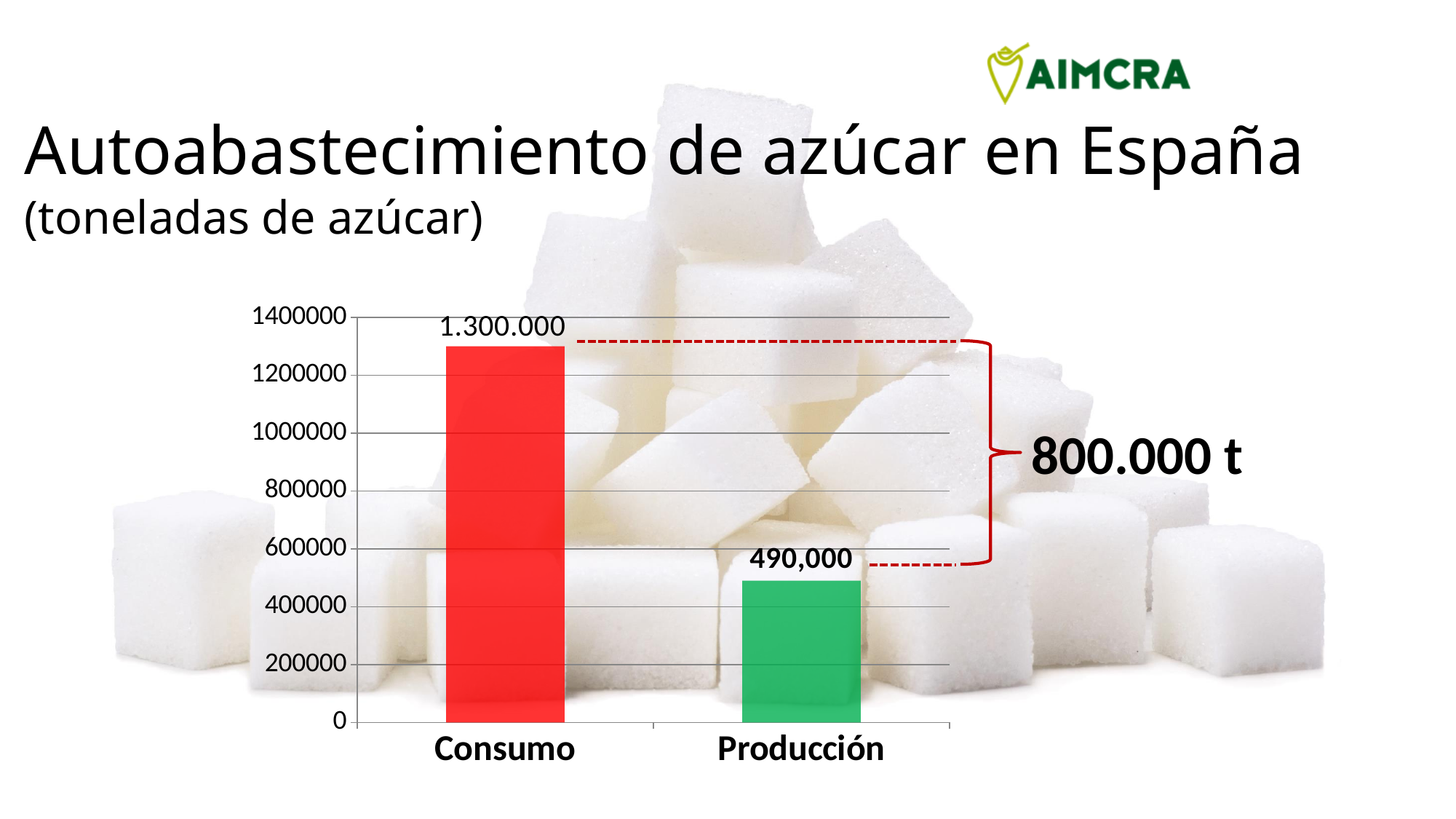
Which is larger, Consumo or Producción? Consumo What colour is the Producción bar? green Is the value for Producción greater or less than 600000? less What is the title of the slide? Autoabastecimiento de azúcar en España What is the value for Consumo? 1.300.000 Which category has the highest value? Consumo What is the value for Producción? 490,000 How many categories are shown on the x axis? 2 Is the value for Consumo greater or less than 1200000? greater What kind of chart is shown on the slide? bar chart Which category has the lowest value? Producción